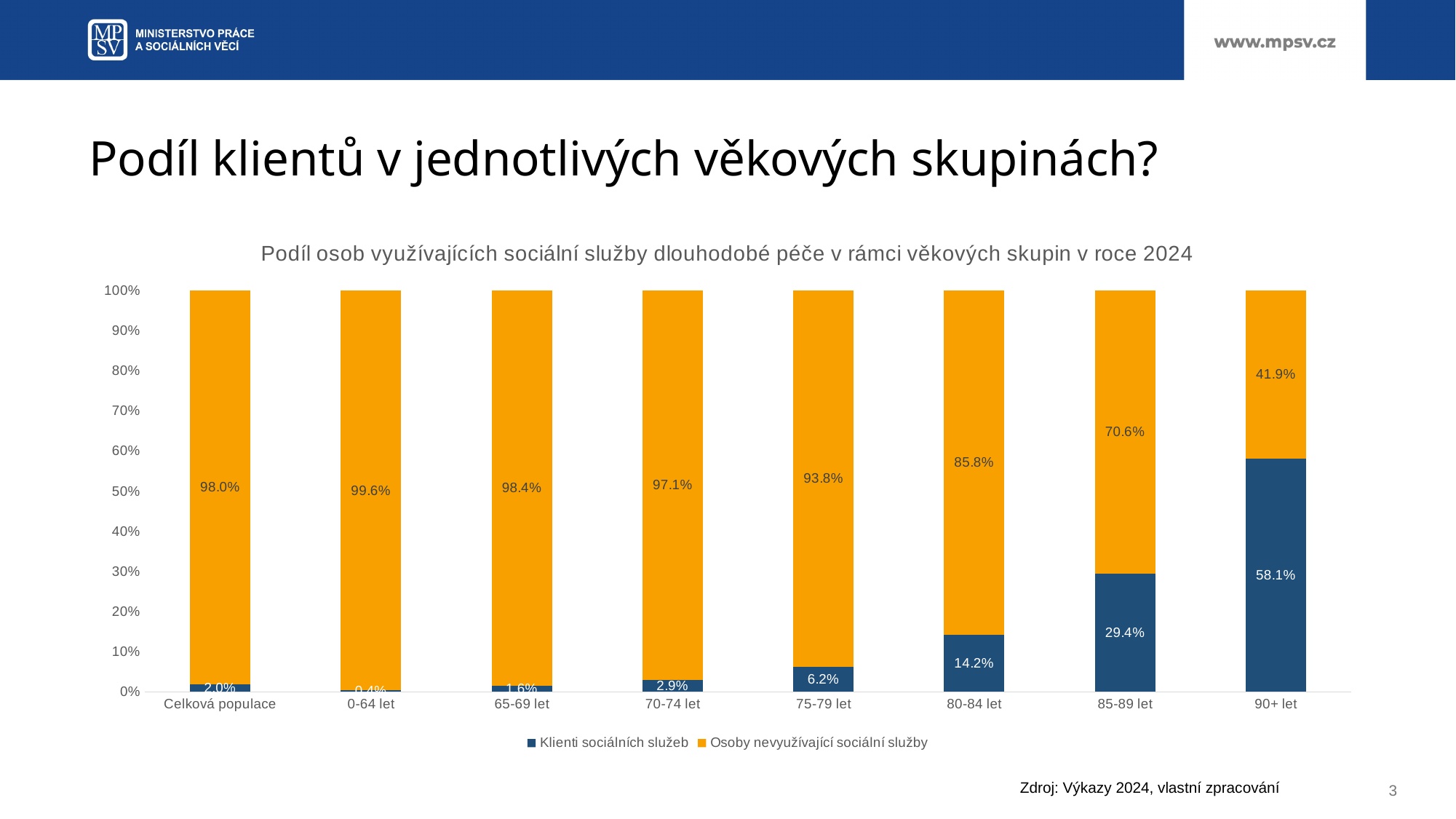
What is the value for 'Klienti sociálních služeb' in the 90+ let age group? 58.1% Which age group has the highest share of 'Klienti sociálních služeb'? 90+ let Which is larger: the 'Klienti sociálních služeb' value for 75-79 let or for 80-84 let? 80-84 let What is the difference between the 'Klienti sociálních služeb' values for 90+ let and 85-89 let? 28.7% How many series does the legend list? 2 Which category has the lowest share of 'Klienti sociálních služeb'? 0-64 let How many categories are shown on the x axis? 8 What is the title of the chart? Podíl osob využívajících sociální služby dlouhodobé péče v rámci věkových skupin v roce 2024 Does the share of 'Klienti sociálních služeb' rise or fall across the age groups from 0-64 let to 90+ let? Rise What kind of chart is shown on the slide? Stacked bar chart What is the value for 'Klienti sociálních služeb' for Celková populace? 2.0% What is the value for 'Osoby nevyužívající sociální služby' in the 80-84 let age group? 85.8%